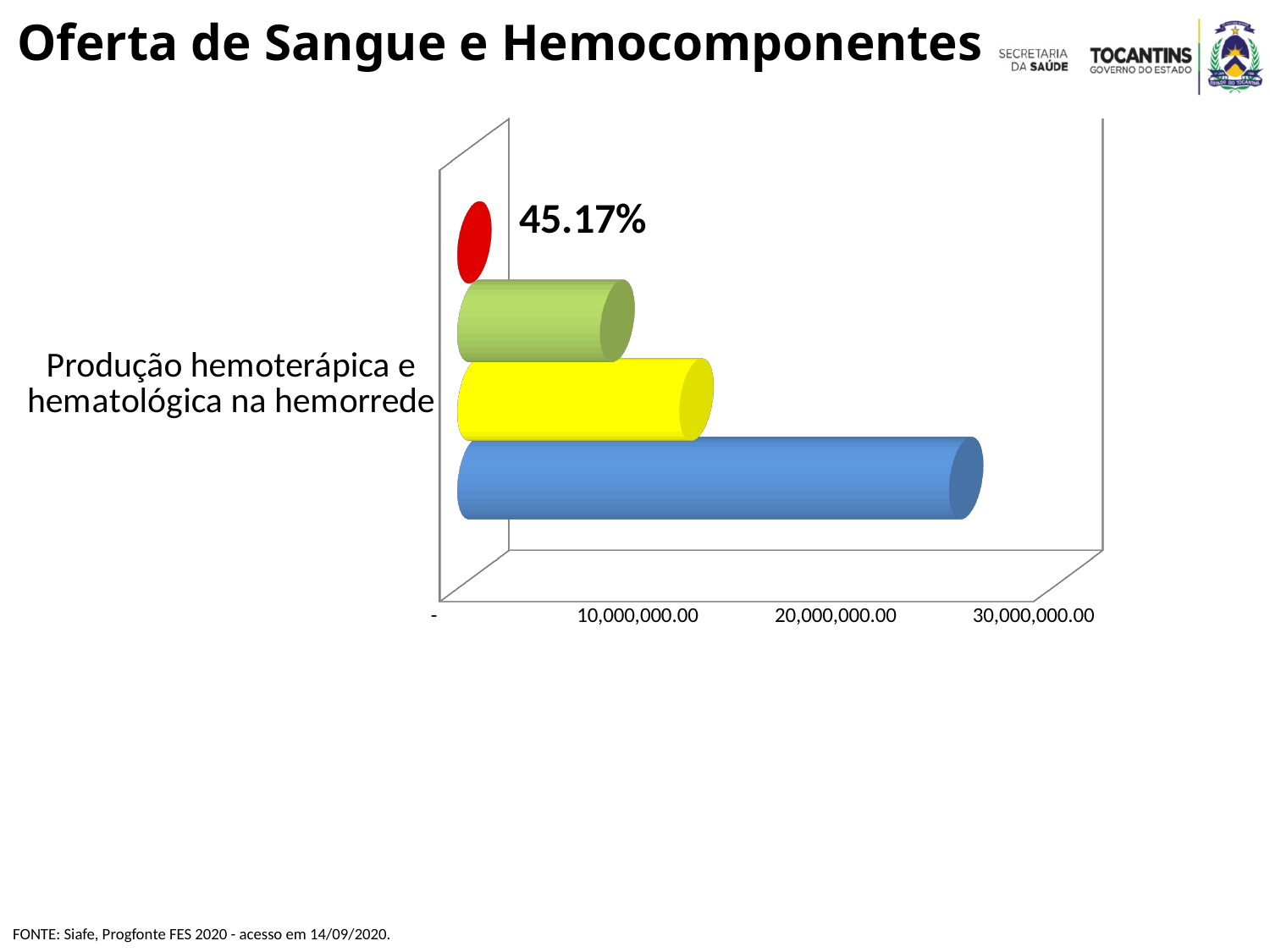
Which bar is longer, the blue bar or the yellow bar? blue Which coloured bar is the shortest in the chart? green Is the value of the yellow bar greater or less than 20,000,000.00? less Which coloured bar is the longest in the chart? blue What kind of chart is shown on the slide? bar chart Is the value of the blue bar greater or less than 20,000,000.00? greater Is the value of the green bar greater or less than 10,000,000.00? less What percentage label is printed on the chart? 45.17% What is the highest tick value shown on the horizontal axis of the chart? 30,000,000.00 How many categories are shown on the vertical axis of the chart? 1 How many bars are plotted for the category "Produção hemoterápica e hematológica na hemorrede"? 3